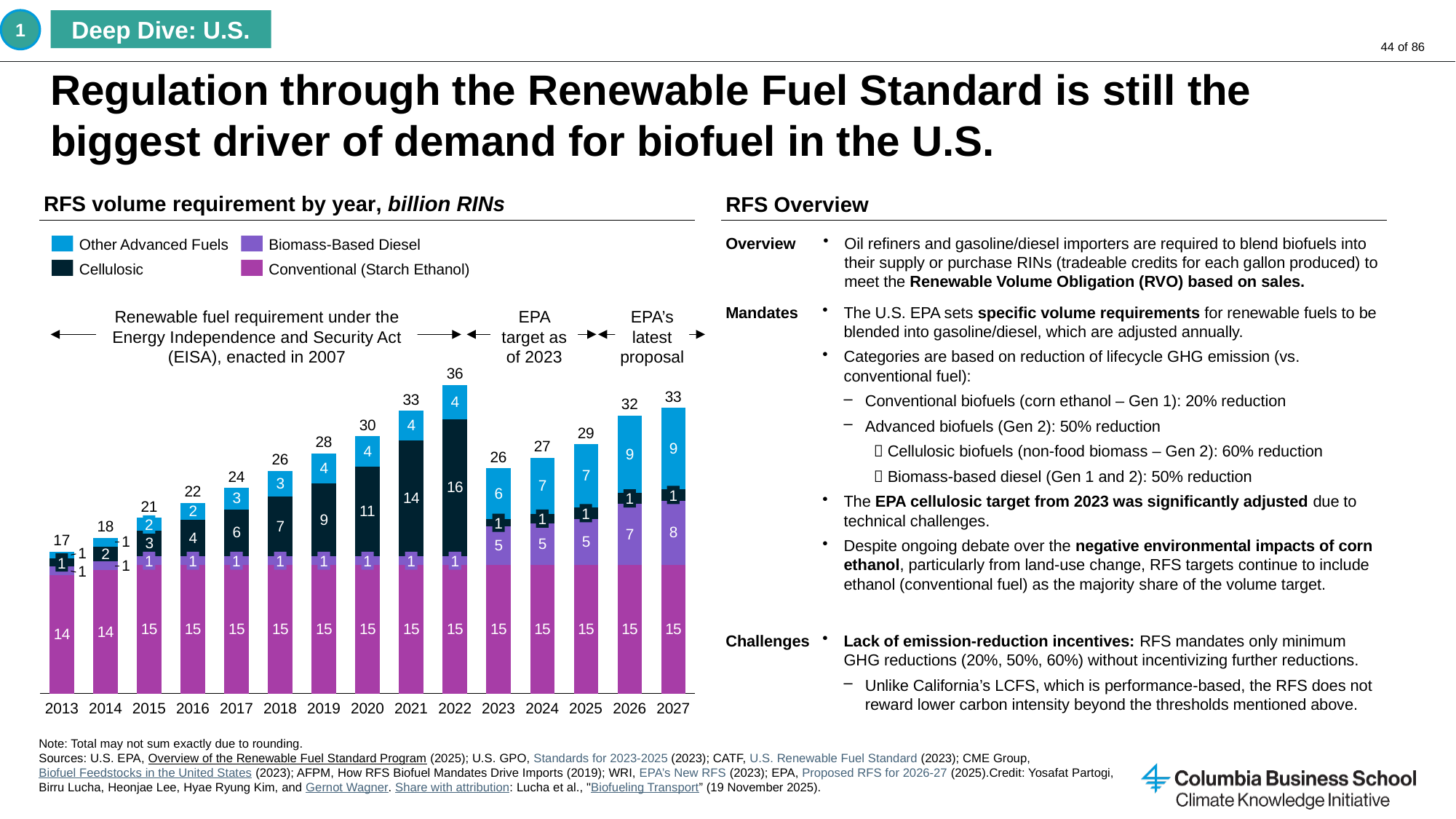
Do the total RFS volume requirements rise or fall from 2013 to 2022? Rise By how much does the total requirement for 2022 exceed the total for 2023? 10 What is the Biomass-Based Diesel value for 2027? 8 What is the Other Advanced Fuels value for 2026? 9 Which year has the lowest total RFS volume requirement? 2013 What type of chart is shown on the slide? Stacked bar chart Which year has the highest total RFS volume requirement? 2022 How many years are shown on the x axis of the chart? 15 What is the total RFS volume requirement for 2022, in billion RINs? 36 How many series does the chart legend list? 4 What is the Cellulosic value for 2022? 16 What is the Conventional (Starch Ethanol) value for 2013? 14